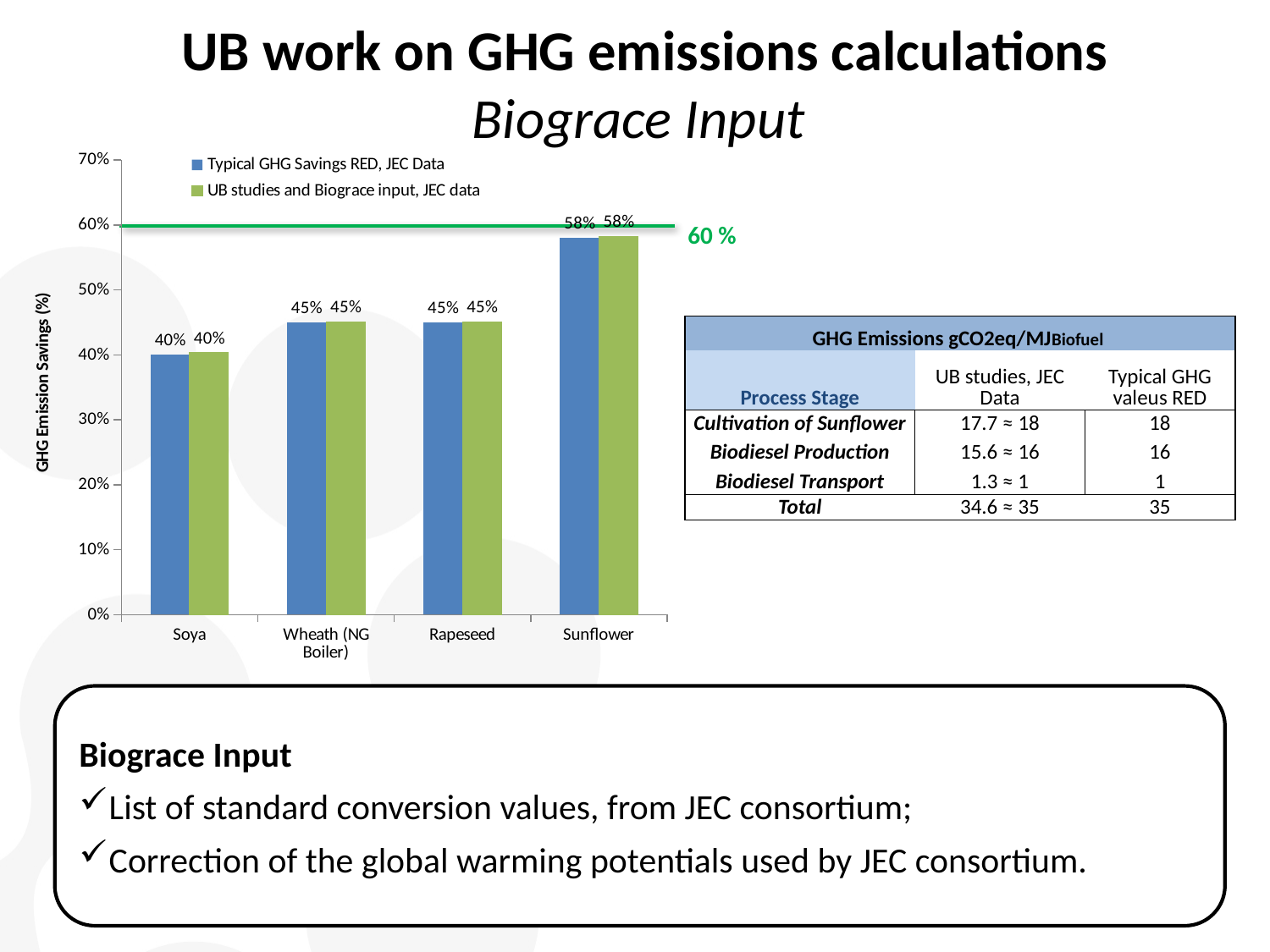
What type of chart is shown on the slide? bar chart Which category has the highest GHG emission savings in the chart? Sunflower What is the value for Rapeseed in the 'Typical GHG Savings RED, JEC Data' series? 45% How many series does the chart legend list? 2 Which is larger: the 'UB studies and Biograce input, JEC data' value for Wheath (NG Boiler) or for Soya? Wheath (NG Boiler) How many categories are shown on the x axis of the chart? 4 What is the difference between the Sunflower and Soya values in the 'Typical GHG Savings RED, JEC Data' series? 18% What is the value for Sunflower in the 'UB studies and Biograce input, JEC data' series? 58% What is the label of the chart's vertical axis? GHG Emission Savings (%) What is the value for Soya in the 'Typical GHG Savings RED, JEC Data' series? 40% Which category has the lowest GHG emission savings in the chart? Soya Is the value for Sunflower in the 'Typical GHG Savings RED, JEC Data' series greater or less than 60%? less